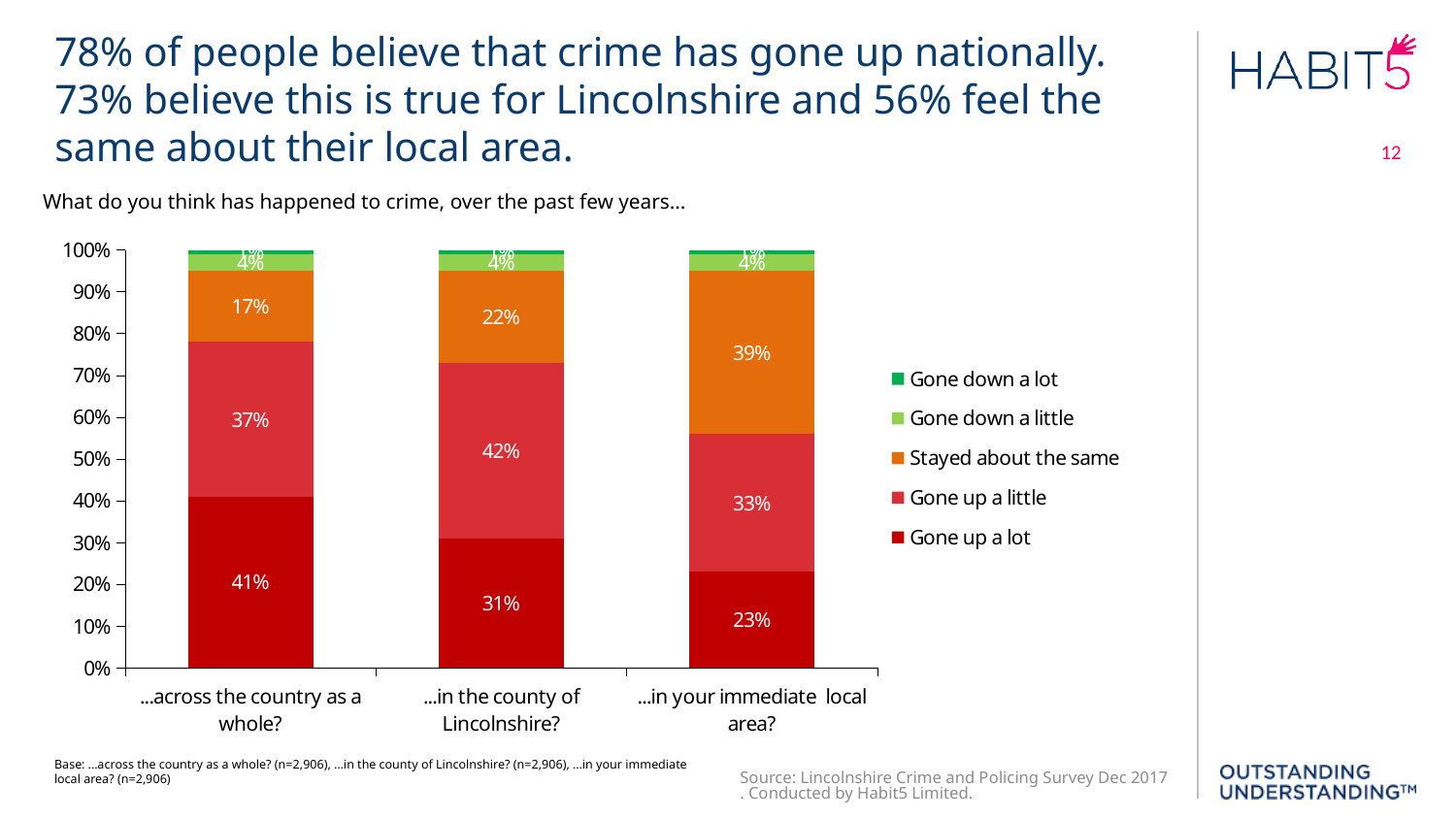
What percentage of respondents said crime has 'Gone down a little' across the country as a whole? 4% What kind of chart is shown on the slide? Stacked bar chart What percentage of respondents said crime has 'Gone up a little' in the county of Lincolnshire? 42% For which area is the 'Gone up a lot' share the highest? ...across the country as a whole? How many areas (categories) are shown on the x axis? 3 Which legend entry is shown in dark red? Gone up a lot What percentage of respondents said crime has 'Stayed about the same' in their immediate local area? 39% For which area is the 'Stayed about the same' share the lowest? ...across the country as a whole? Which is larger: the 'Gone up a little' share in the county of Lincolnshire or in the immediate local area? in the county of Lincolnshire What is the difference between the 'Gone up a lot' share across the country as a whole and in the immediate local area? 18 percentage points How many series does the legend list? 5 What percentage of respondents said crime has 'Gone up a lot' across the country as a whole? 41%